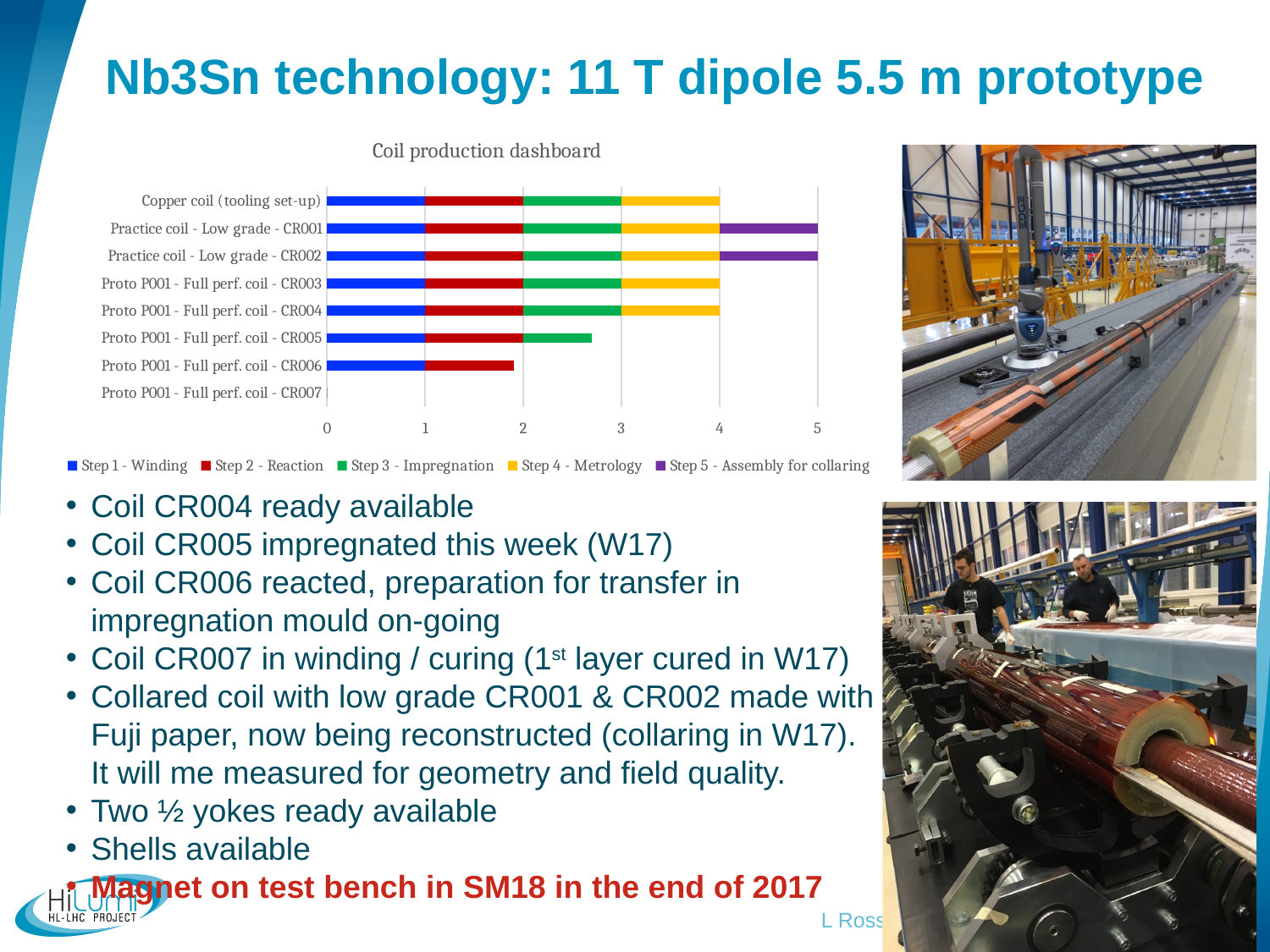
Which coil has the shortest bar in the Coil production dashboard? Proto P001 - Full perf. coil - CR007 What is the total length of the stacked bar for 'Practice coil - Low grade - CR001'? 5 Which bar is longer: 'Proto P001 - Full perf. coil - CR004' or 'Proto P001 - Full perf. coil - CR006'? Proto P001 - Full perf. coil - CR004 How many series does the legend of the Coil production dashboard list? 5 Which step does the purple series in the legend represent? Step 5 - Assembly for collaring Is the total bar length for 'Proto P001 - Full perf. coil - CR005' greater or less than 3? less What is the total length of the stacked bar for 'Copper coil (tooling set-up)'? 4 How many coil categories are shown on the y axis of the Coil production dashboard? 8 What kind of chart is the Coil production dashboard? Stacked bar chart What is the title of the chart on the slide? Coil production dashboard What is the total length of the stacked bar for 'Proto P001 - Full perf. coil - CR003'? 4 Is the total bar length for 'Proto P001 - Full perf. coil - CR006' greater or less than 1? greater